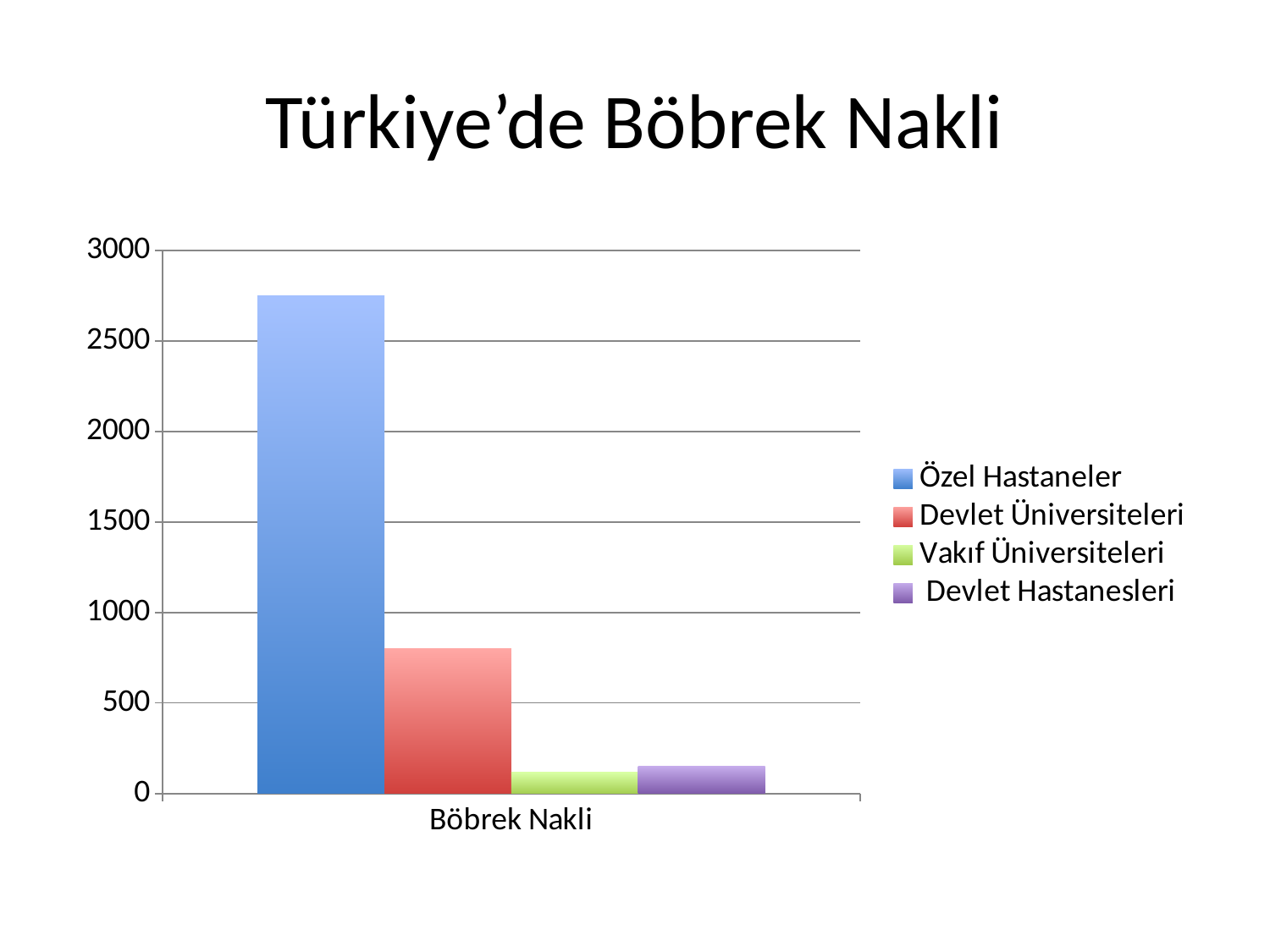
Is the value for Devlet Üniversiteleri greater or less than 500? greater Is the value for Özel Hastaneler greater or less than 2500? greater What type of chart is shown on the slide? bar chart What is the title of the slide? Türkiye'de Böbrek Nakli Is the value for Devlet Üniversiteleri greater or less than 1000? less What is the label of the category on the x axis? Böbrek Nakli Which series has the highest value? Özel Hastaneler How many series does the legend list? 4 How many categories are shown on the x axis? 1 Which is larger, the value for Özel Hastaneler or the value for Devlet Üniversiteleri? Özel Hastaneler